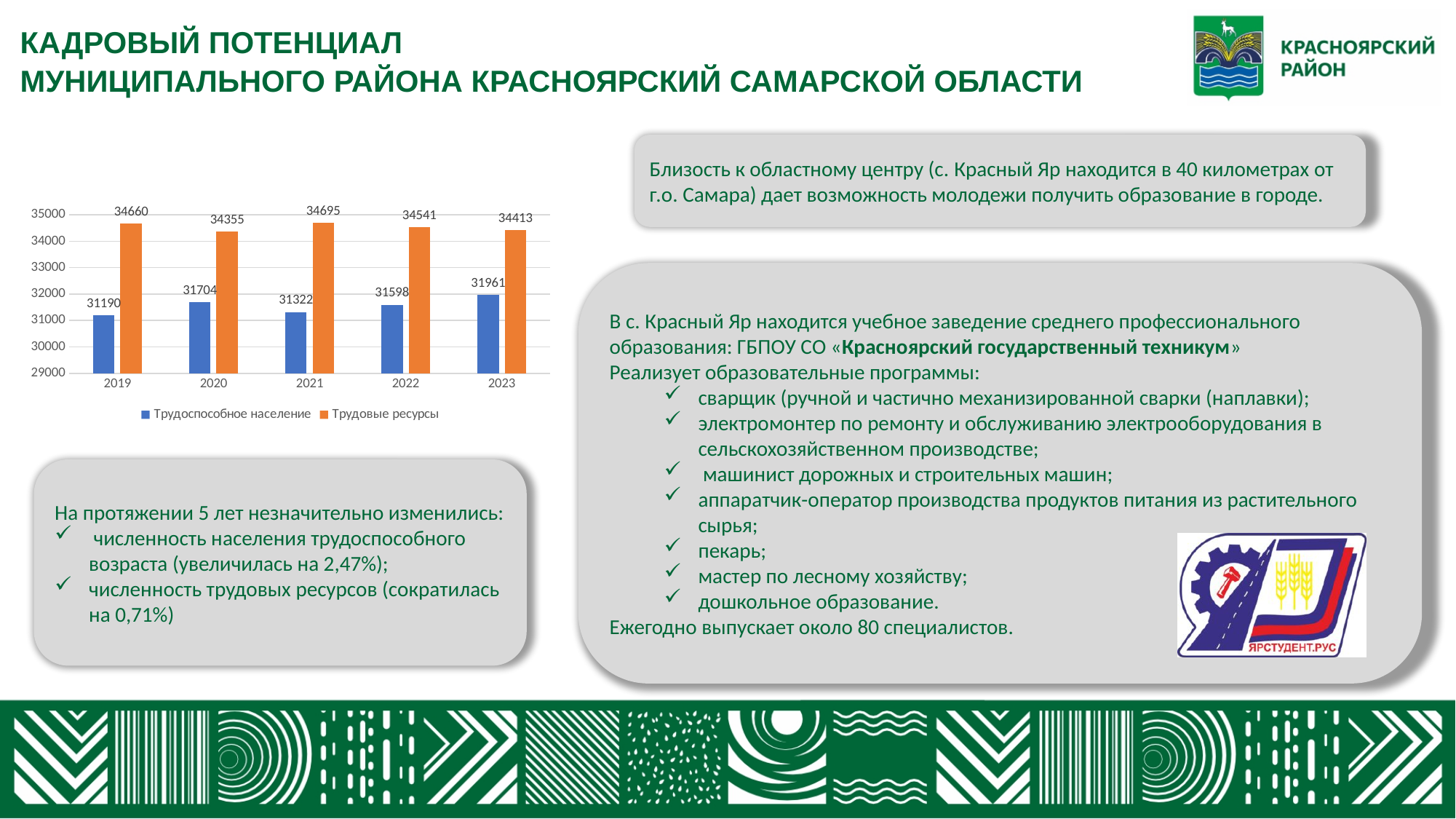
What is the value of Трудоспособное население for 2023? 31961 How many years are shown on the x axis of the chart? 5 In which year is Трудовые ресурсы the lowest? 2020 Which colour represents Трудовые ресурсы in the chart? orange Which is larger in 2020: Трудоспособное население or Трудовые ресурсы? Трудовые ресурсы What is the value of Трудоспособное население for 2019? 31190 How many series does the chart legend list? 2 Is the value of Трудоспособное население for 2021 greater or less than 32000? less What is the value of Трудовые ресурсы for 2021? 34695 In which year is Трудоспособное население the highest? 2023 What is the difference between Трудовые ресурсы and Трудоспособное население in 2022? 2943 What type of chart is shown on the slide? bar chart